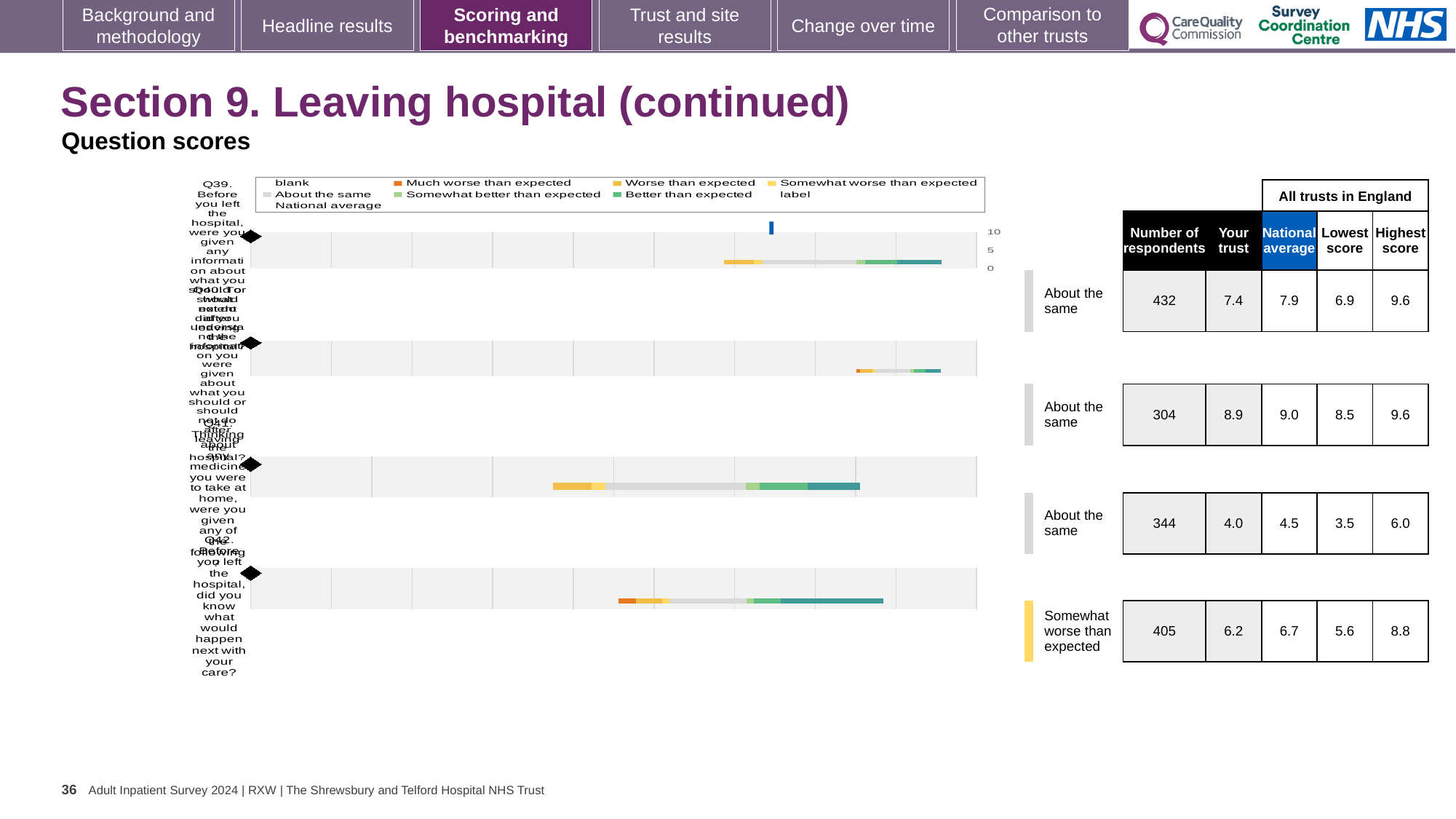
In the table beside the chart, what is the 'Your trust' score for the first row (Q39)? 7.4 In the chart legend, what colour represents 'Much worse than expected'? orange What benchmark category is given for the last row (Q42)? Somewhat worse than expected In the table beside the chart, how many respondents are listed for the last row (Q42)? 405 In the table beside the chart, what is the lowest score for the last row (Q42)? 5.6 For the first row (Q39), what is the difference between the national average and the 'Your trust' score? 0.5 What kind of chart is shown on the slide? bar chart Which row has the lowest 'Your trust' score in the table beside the chart? the third row (4.0) In the table beside the chart, what is the national average for the third row? 4.5 How many question bars are plotted in the chart? 4 For the last row (Q42), is the 'Your trust' score higher or lower than the national average? lower Which row has the highest 'Your trust' score in the table beside the chart? the second row (8.9)